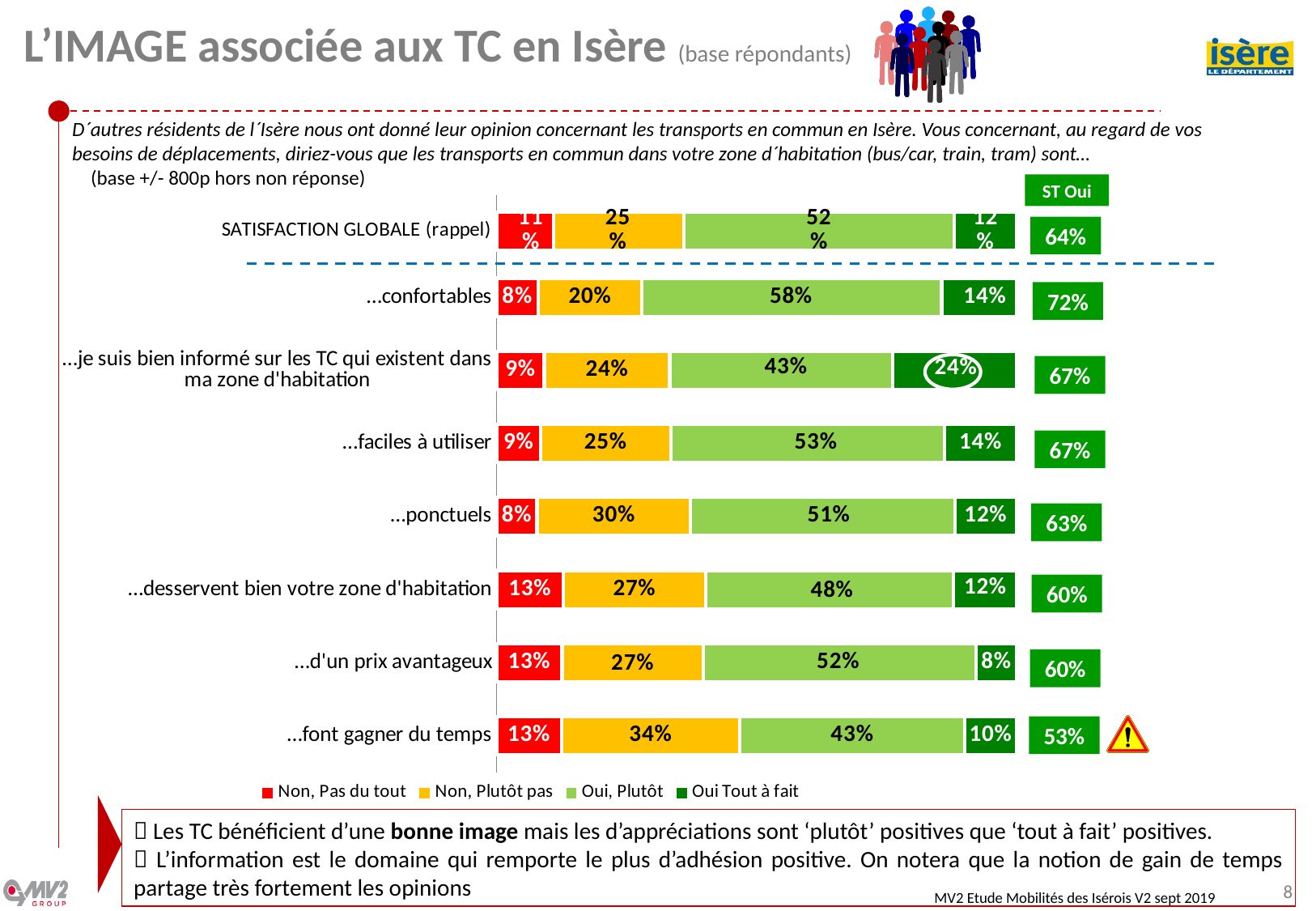
How many series does the chart legend list? 4 What is the 'Non, Plutôt pas' value for '…font gagner du temps'? 34% Which category has the highest 'Oui Tout à fait' value? …je suis bien informé sur les TC qui existent dans ma zone d'habitation Which category has the lowest 'Oui Tout à fait' value? …d'un prix avantageux What kind of chart is shown on the slide? Stacked bar chart How many categories (rows) are plotted in the chart, including SATISFACTION GLOBALE (rappel)? 8 What is the difference between the 'Oui, Plutôt' values for '…confortables' and '…font gagner du temps'? 15 percentage points What is the 'Oui, Plutôt' value for '…confortables'? 58% Which has the larger 'Non, Plutôt pas' value: '…ponctuels' or '…faciles à utiliser'? …ponctuels What is the total of the stacked bar for '…confortables'? 100% What is the 'Non, Pas du tout' value for '…desservent bien votre zone d'habitation'? 13% Which legend entry is shown in red? Non, Pas du tout